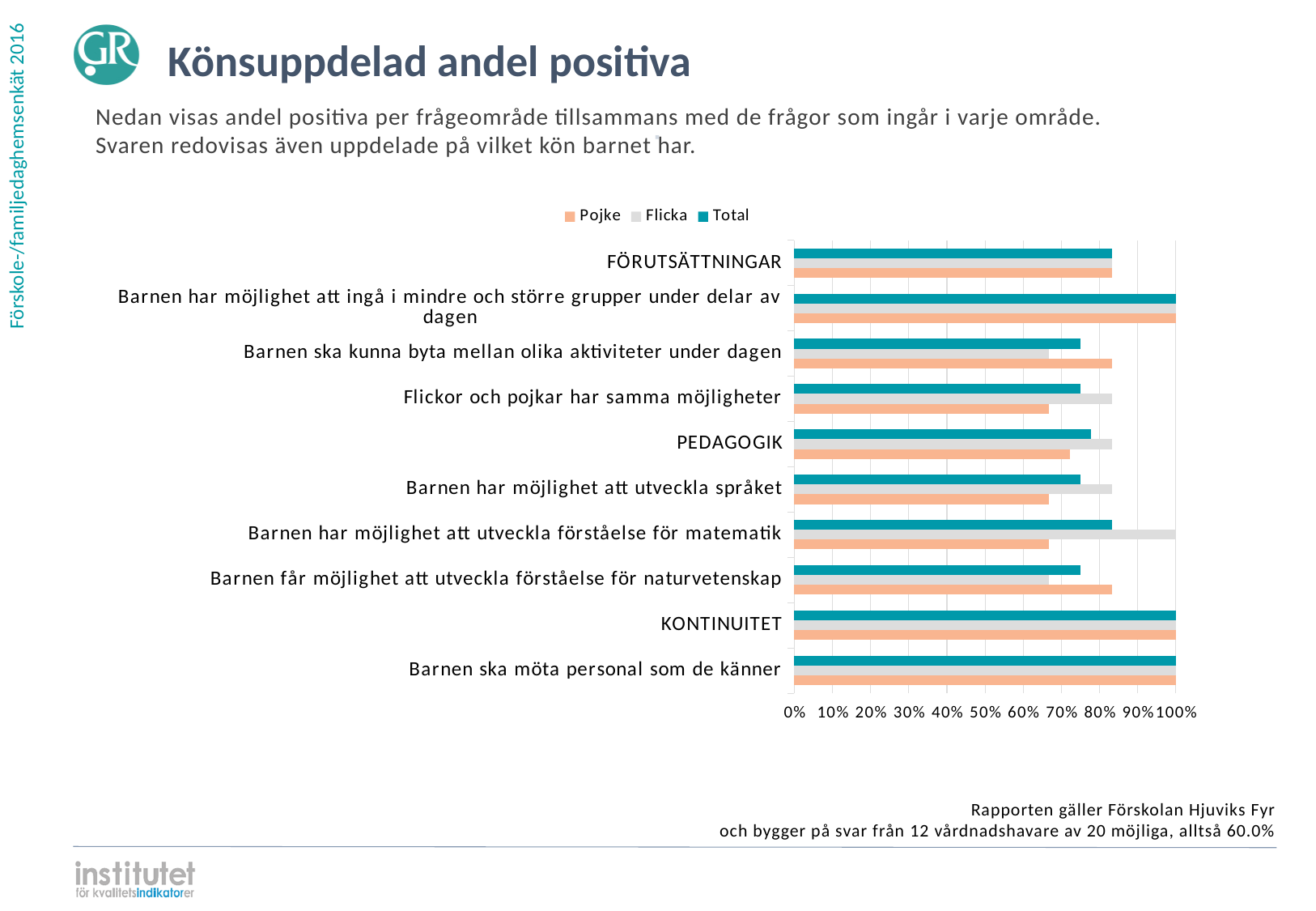
Is the Total value for FÖRUTSÄTTNINGAR greater or less than 80%? greater How many series does the legend list? 3 What is the Pojke value for 'Barnen ska möta personal som de känner'? 100% What is the Total value for KONTINUITET? 100% For 'Barnen ska kunna byta mellan olika aktiviteter under dagen', which is larger, the Pojke value or the Flicka value? Pojke Which series is shown in teal in the legend? Total Is the Flicka value for 'Barnen ska kunna byta mellan olika aktiviteter under dagen' greater or less than 70%? less Is the Pojke value for 'Barnen har möjlighet att utveckla förståelse för matematik' greater or less than 70%? less What is the Flicka value for 'Barnen har möjlighet att ingå i mindre och större grupper under delar av dagen'? 100% What kind of chart is shown on the slide? bar chart How many categories are shown on the chart? 10 For 'Flickor och pojkar har samma möjligheter', which is larger, the Pojke value or the Flicka value? Flicka